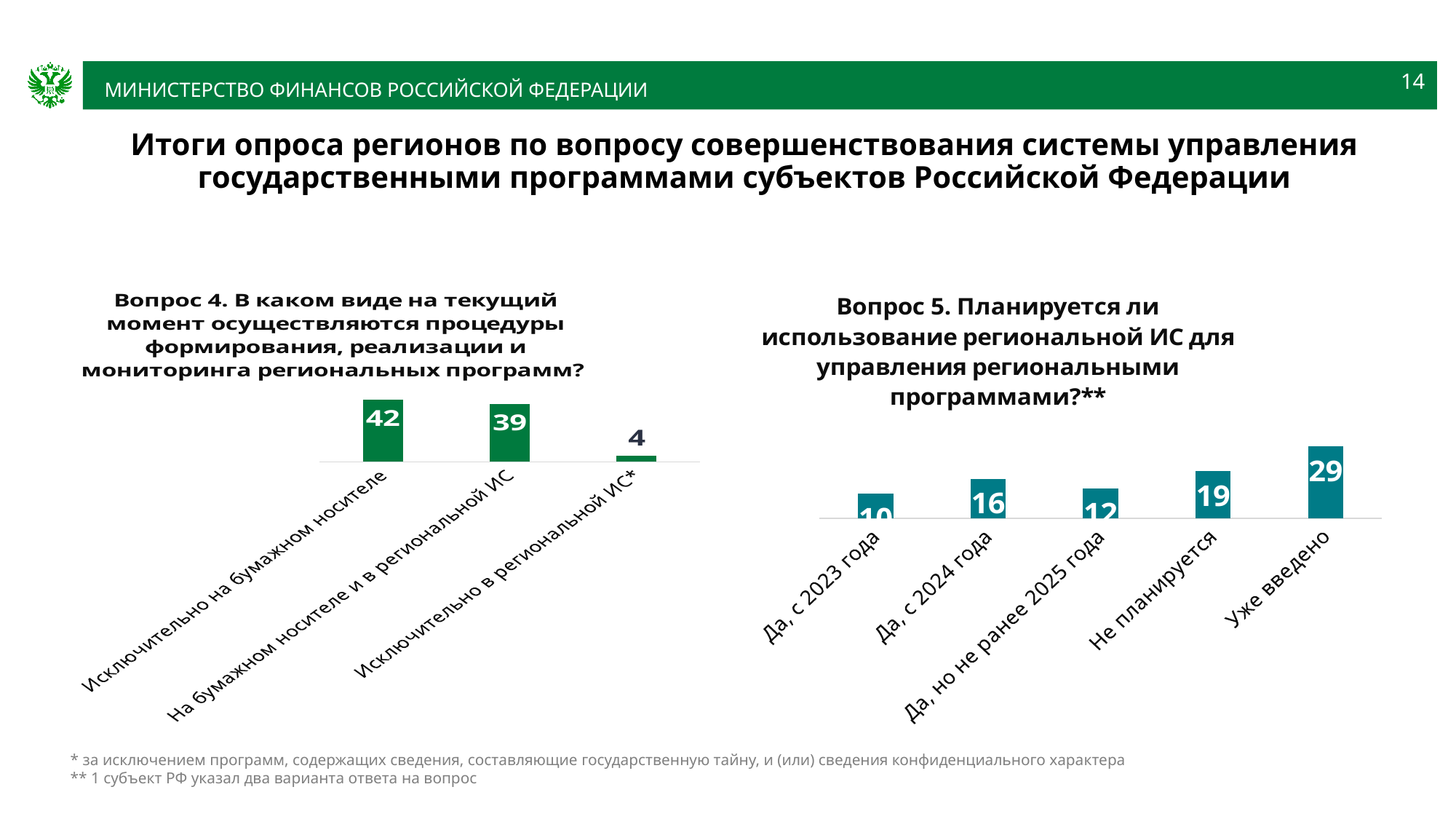
Сколько категорий показано на диаграмме «Вопрос 5»? 5 На диаграмме «Вопрос 5» на сколько значение «Уже введено» больше значения «Не планируется»? 10 На диаграмме «Вопрос 4» на сколько значение «Исключительно на бумажном носителе» больше значения «На бумажном носителе и в региональной ИС»? 3 Какого типа диаграмма «Вопрос 5»? Столбчатая (bar chart) На диаграмме «Вопрос 5» что больше: значение «Не планируется» или «Да, но не ранее 2025 года»? Не планируется На диаграмме «Вопрос 4» какое значение указано для категории «Исключительно в региональной ИС*»? 4 На диаграмме «Вопрос 5» какая категория имеет наименьшее значение? Да, с 2023 года На диаграмме «Вопрос 4» какая категория имеет наибольшее значение? Исключительно на бумажном носителе На диаграмме «Вопрос 5» какое значение указано для категории «Уже введено»? 29 На диаграмме «Вопрос 4» какое значение указано для категории «Исключительно на бумажном носителе»? 42 На диаграмме «Вопрос 5» какое значение указано для категории «Да, с 2024 года»? 16 Сколько категорий показано на диаграмме «Вопрос 4»? 3